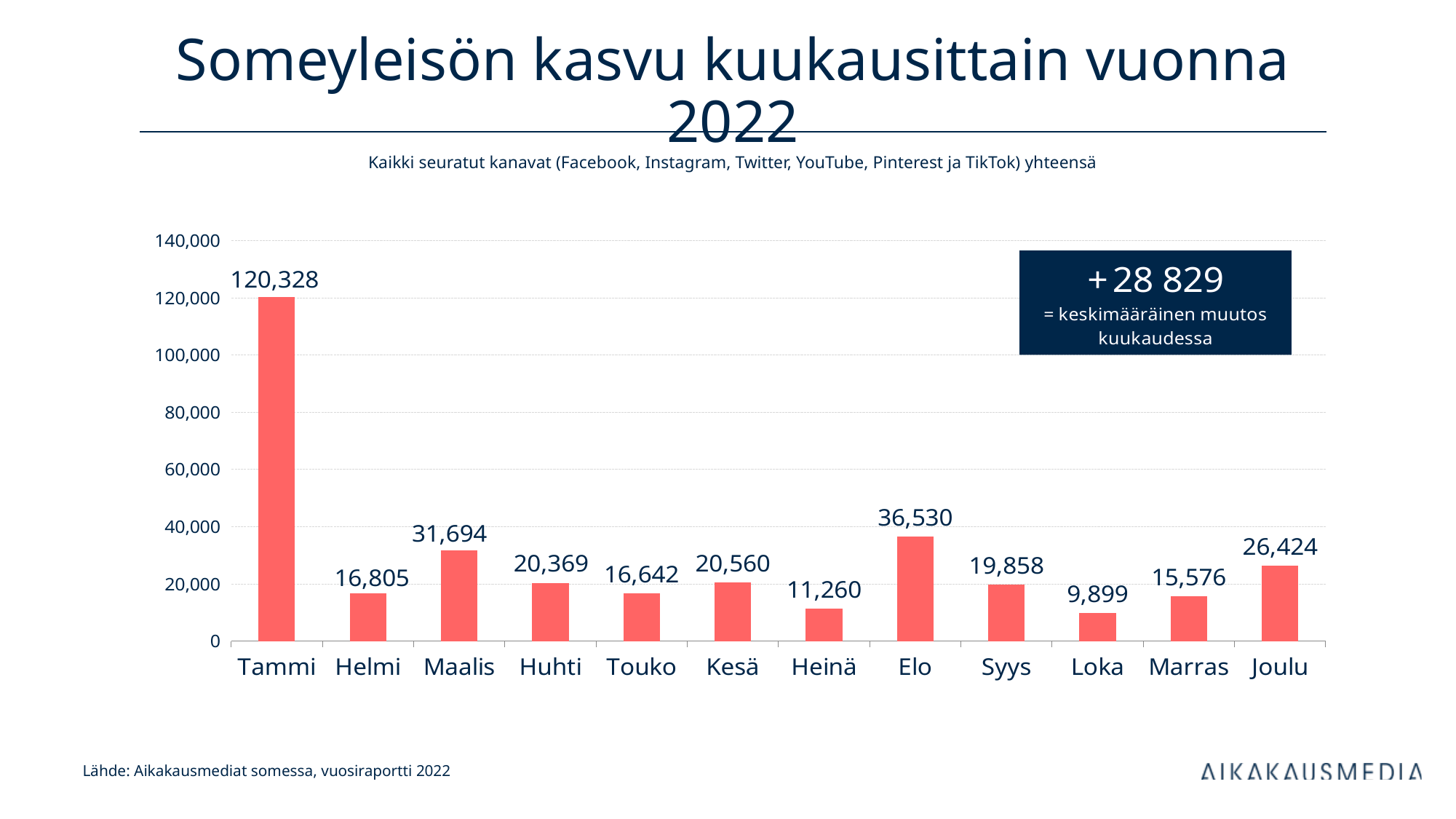
What is the value for Tammi? 120,328 What average monthly change is stated in the box on the chart? +28 829 What kind of chart is shown on the slide? bar chart Which month has the highest value? Tammi What is the value for Elo? 36,530 Is the value for Heinä greater or less than 20,000? less What is the difference between the values for Elo and Maalis? 4,836 Which month has the lowest value? Loka What is the value for Loka? 9,899 What is the value for Joulu? 26,424 How many months are shown on the x axis? 12 Which is larger, the value for Huhti or the value for Syys? Huhti